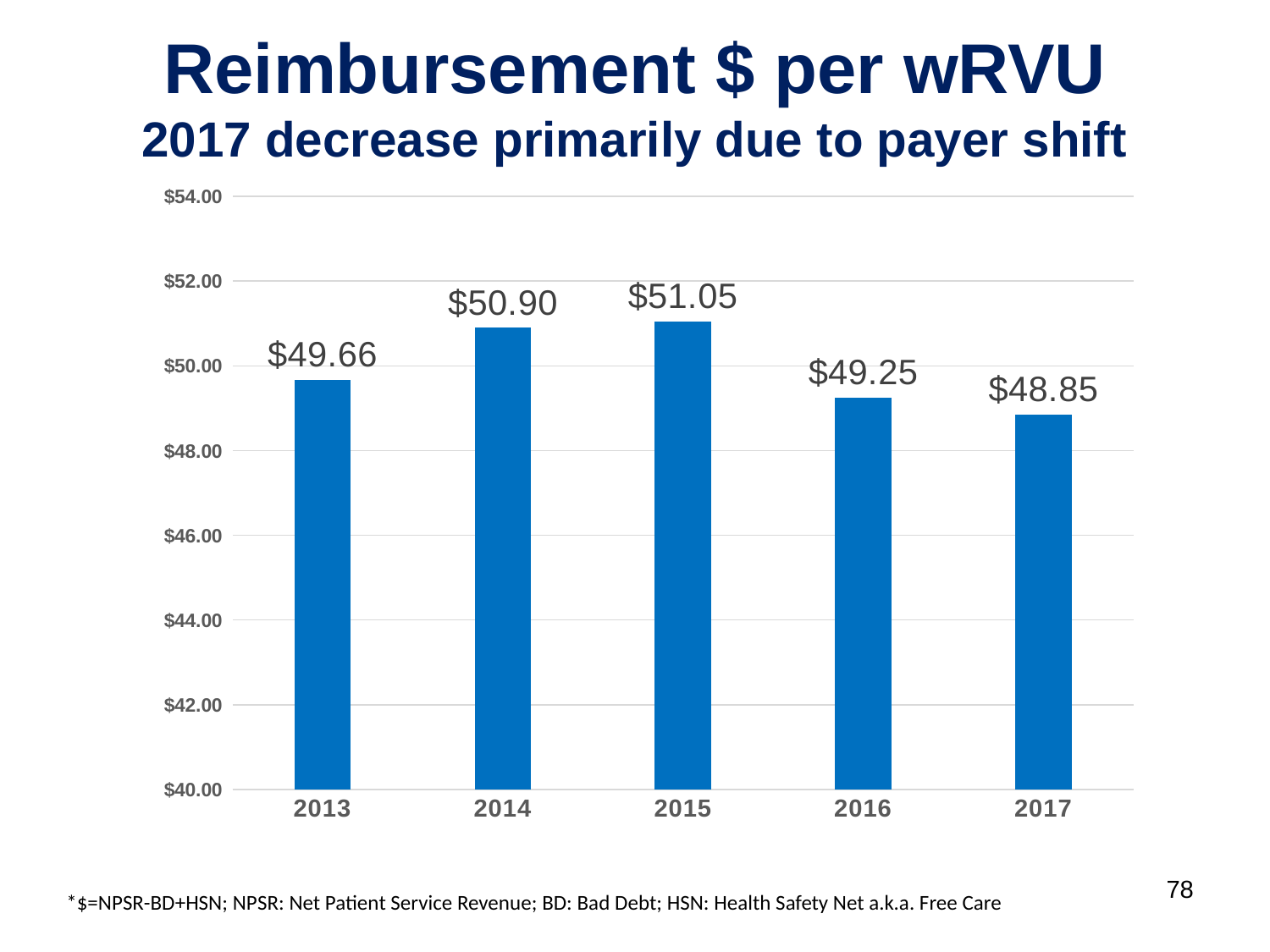
What kind of chart is shown on the slide? bar chart What is the difference between the 2014 value and the 2013 value? $1.24 Is the value for 2016 greater or less than $50.00? less What is the value shown for 2015? $51.05 What is the difference between the 2015 value and the 2017 value? $2.20 How many years are shown on the chart? 5 What is the reimbursement $ per wRVU for 2013? $49.66 Do the values rise or fall from 2015 to 2017? fall Which year has the lowest reimbursement $ per wRVU? 2017 What is the reimbursement $ per wRVU for 2017? $48.85 Which is larger, the value for 2014 or the value for 2016? 2014 Which year has the highest reimbursement $ per wRVU? 2015